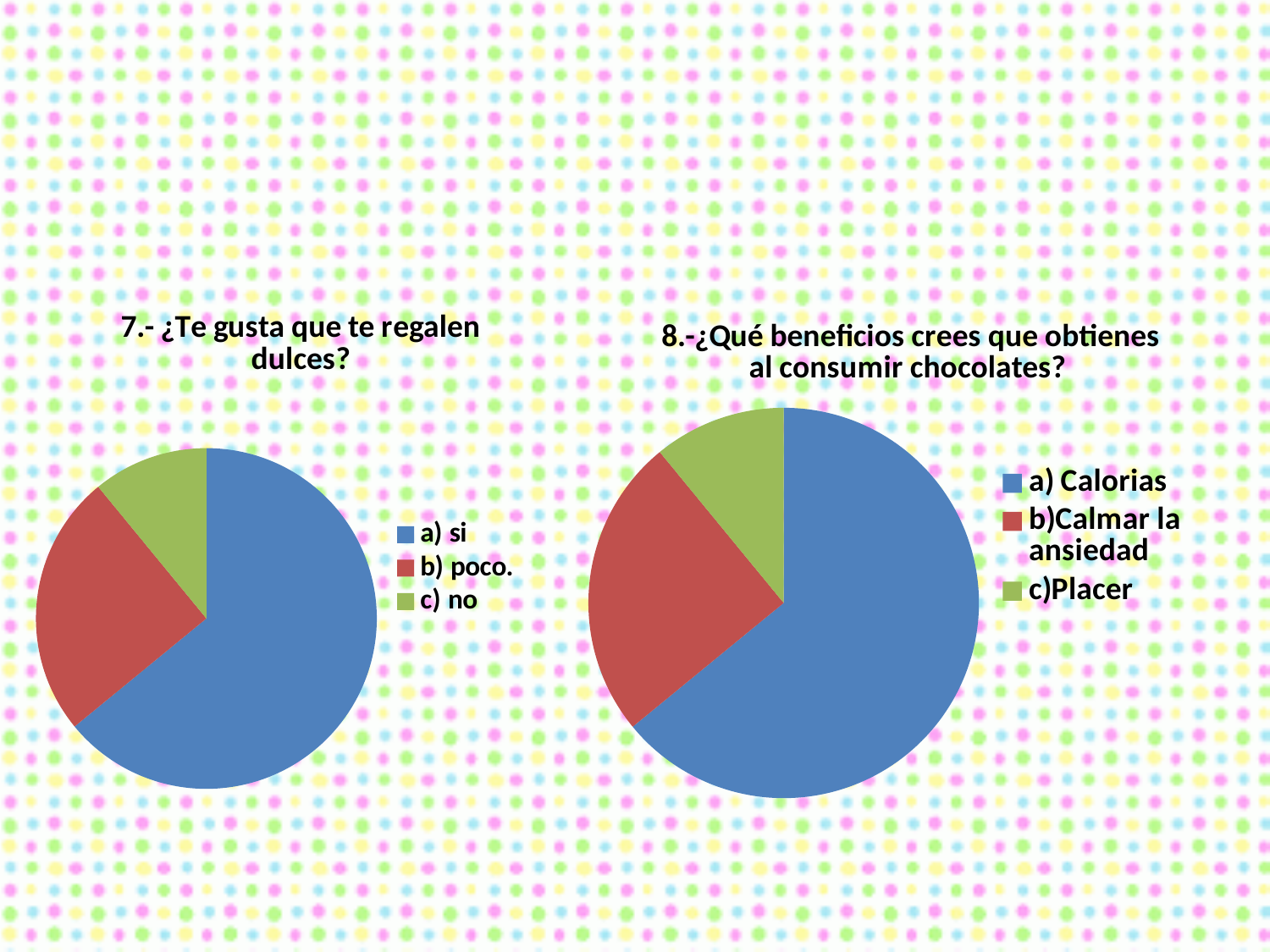
What kind of chart is the chart titled "8.-¿Qué beneficios crees que obtienes al consumir chocolates?"? Pie chart In the chart titled "7.- ¿Te gusta que te regalen dulces?", what colour is the slice for c) no? Green What kind of chart is the chart titled "7.- ¿Te gusta que te regalen dulces?"? Pie chart In the chart titled "7.- ¿Te gusta que te regalen dulces?", which category has the smallest slice? c) no In the chart titled "8.-¿Qué beneficios crees que obtienes al consumir chocolates?", which category has the largest slice? a) Calorias In the chart titled "7.- ¿Te gusta que te regalen dulces?", which slice is larger: b) poco. or c) no? b) poco. In the chart titled "8.-¿Qué beneficios crees que obtienes al consumir chocolates?", which slice is larger: a) Calorias or b)Calmar la ansiedad? a) Calorias What is the title of the pie chart on the right side of the slide? 8.-¿Qué beneficios crees que obtienes al consumir chocolates? In the chart titled "7.- ¿Te gusta que te regalen dulces?", how many slices does the pie have? 3 In the chart titled "7.- ¿Te gusta que te regalen dulces?", which category has the largest slice? a) si In the chart titled "8.-¿Qué beneficios crees que obtienes al consumir chocolates?", how many categories does the legend list? 3 In the chart titled "8.-¿Qué beneficios crees que obtienes al consumir chocolates?", which category has the smallest slice? c)Placer